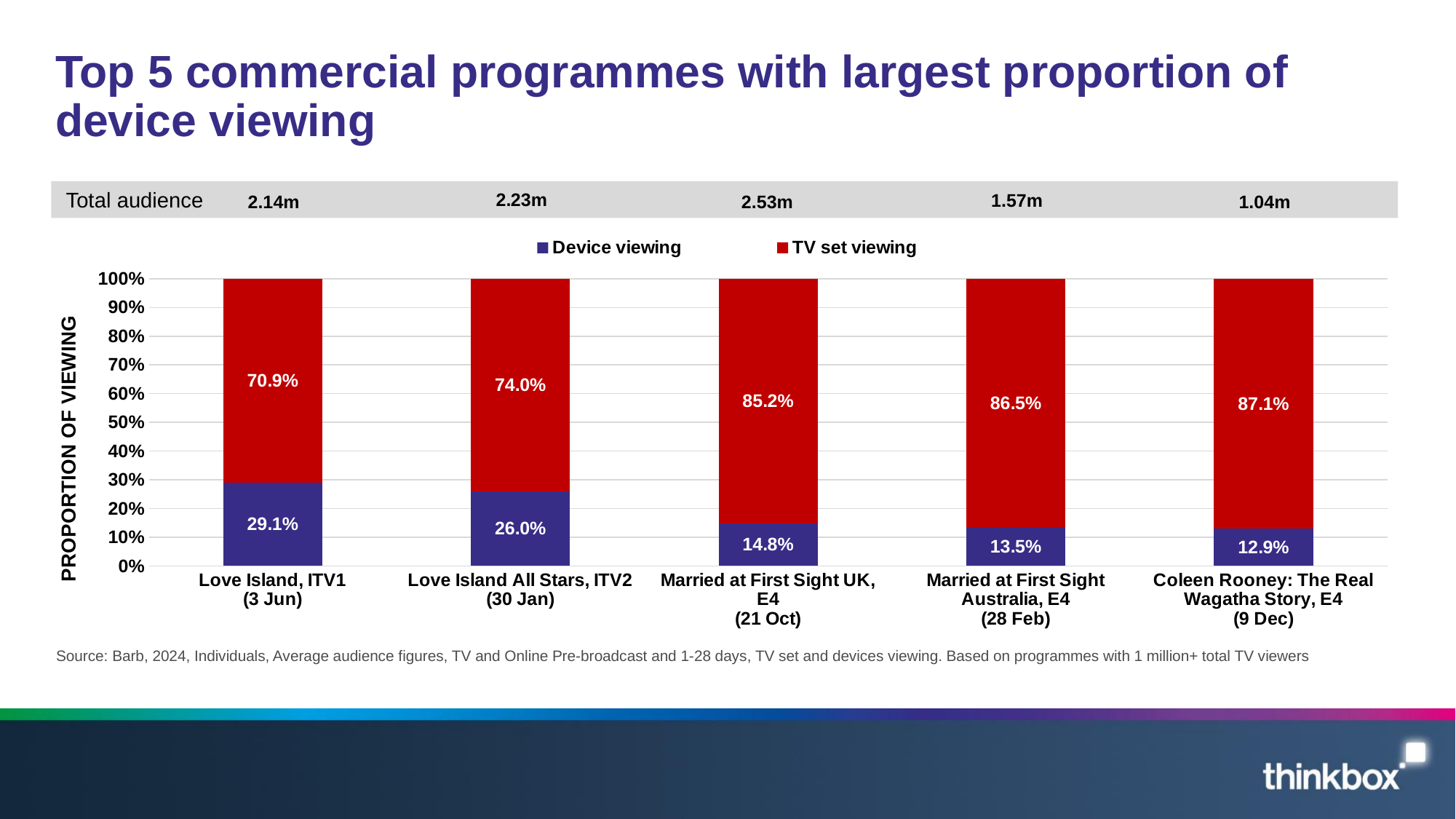
What is the difference between the Device viewing values for Love Island, ITV1 and Love Island All Stars, ITV2? 3.1% Is the Device viewing value for Married at First Sight UK, E4 greater or less than 20%? less Which programme has the lowest TV set viewing proportion? Love Island, ITV1 (3 Jun) What is the Device viewing value for Love Island, ITV1 (3 Jun)? 29.1% What is the Device viewing value for Coleen Rooney: The Real Wagatha Story, E4 (9 Dec)? 12.9% What is the total audience shown for Married at First Sight UK, E4 (21 Oct)? 2.53m What kind of chart is shown on the slide? Stacked bar chart What is the TV set viewing value for Married at First Sight Australia, E4 (28 Feb)? 86.5% How many series does the legend list? 2 How many programmes are shown on the chart? 5 Which programme has the highest Device viewing proportion? Love Island, ITV1 (3 Jun) Which is larger: the TV set viewing value for Married at First Sight UK, E4 or for Love Island All Stars, ITV2? Married at First Sight UK, E4